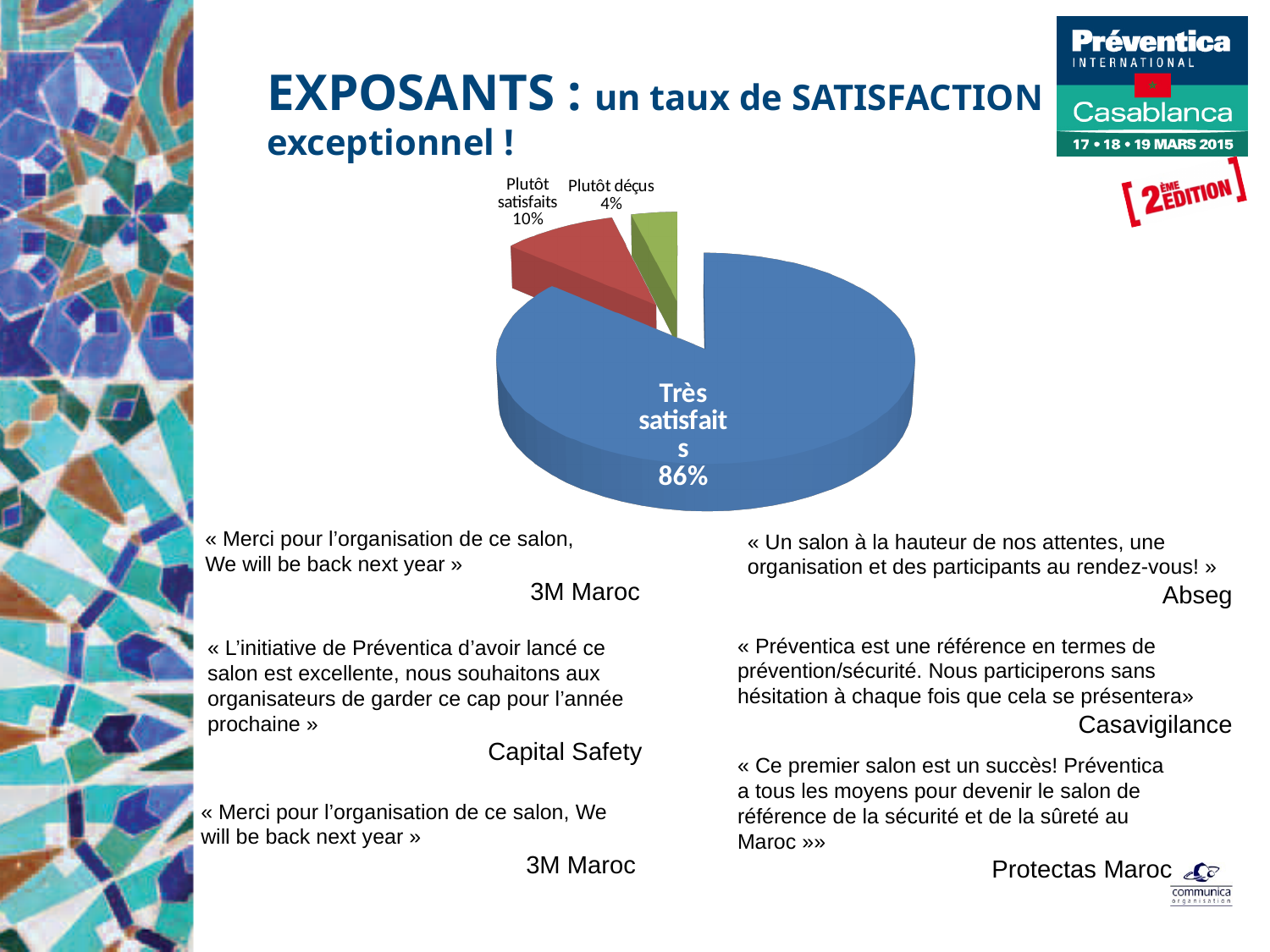
Which category has the smallest share of the pie? Plutôt déçus What colour is the 'Très satisfaits' slice? blue What is the difference in percentage points between 'Plutôt satisfaits' and 'Plutôt déçus'? 6 Which category has the largest share of the pie? Très satisfaits How many slices does the pie chart have? 3 What percentage of exhibitors are 'Très satisfaits'? 86% What kind of chart is shown on the slide? pie chart Which is larger, the share for 'Plutôt satisfaits' or for 'Plutôt déçus'? Plutôt satisfaits What is the difference in percentage points between 'Très satisfaits' and 'Plutôt satisfaits'? 76 What is the combined share of 'Plutôt satisfaits' and 'Plutôt déçus'? 14% What percentage of exhibitors are 'Plutôt satisfaits'? 10% What percentage of exhibitors are 'Plutôt déçus'? 4%